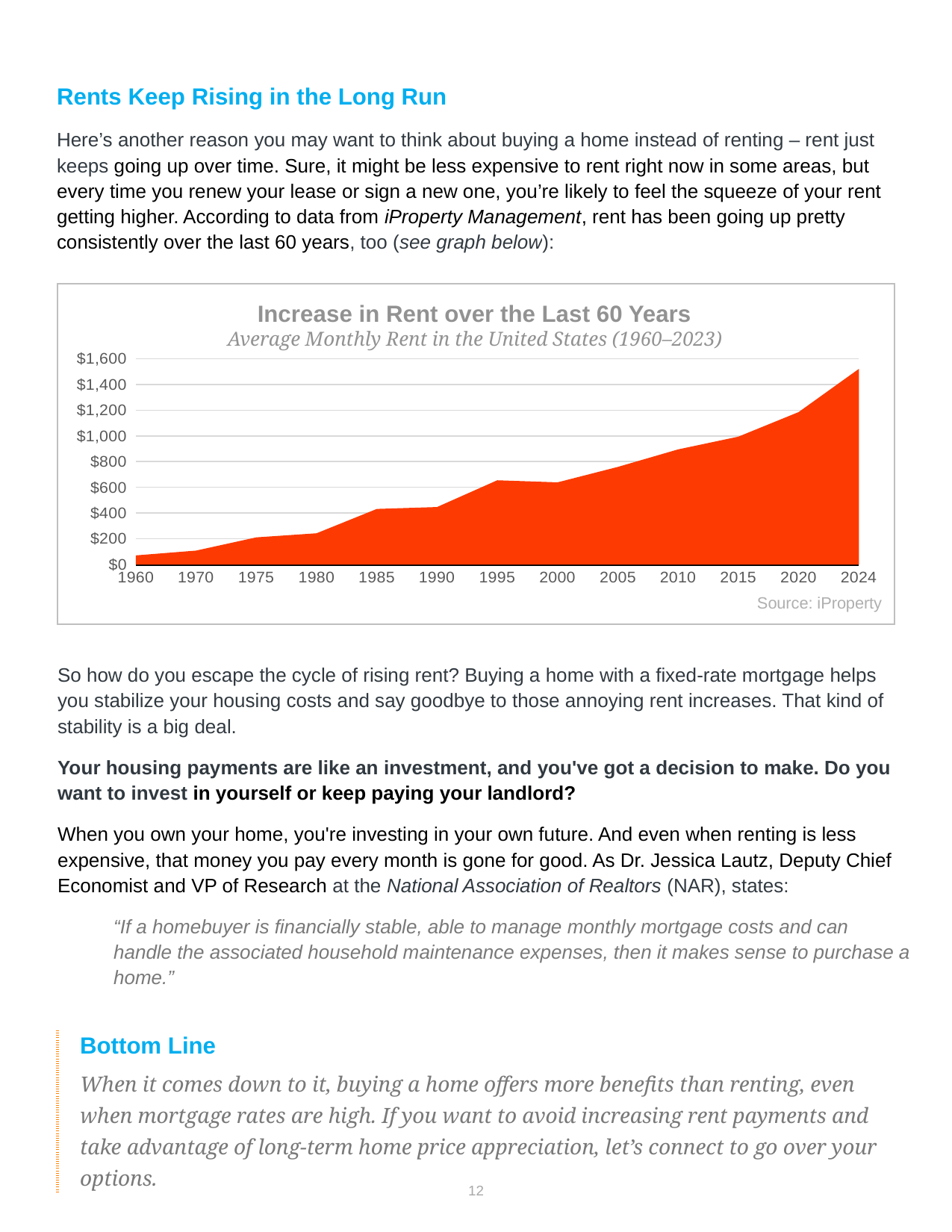
Is the value for 2020 greater or less than $1,000? greater How many years are labeled along the x axis of the chart? 13 Which year has the lowest average monthly rent in the chart? 1960 Do the rent values generally rise or fall from 1960 to 2024? Rise Is the value for 2010 greater or less than $800? greater Is the value for 2024 greater or less than $1,400? greater Which year has a larger average monthly rent, 2010 or 1990? 2010 What kind of chart is shown on the slide? Area chart What is the title of the chart? Increase in Rent over the Last 60 Years Which year has the highest average monthly rent in the chart? 2024 What source is cited for the chart data? iProperty